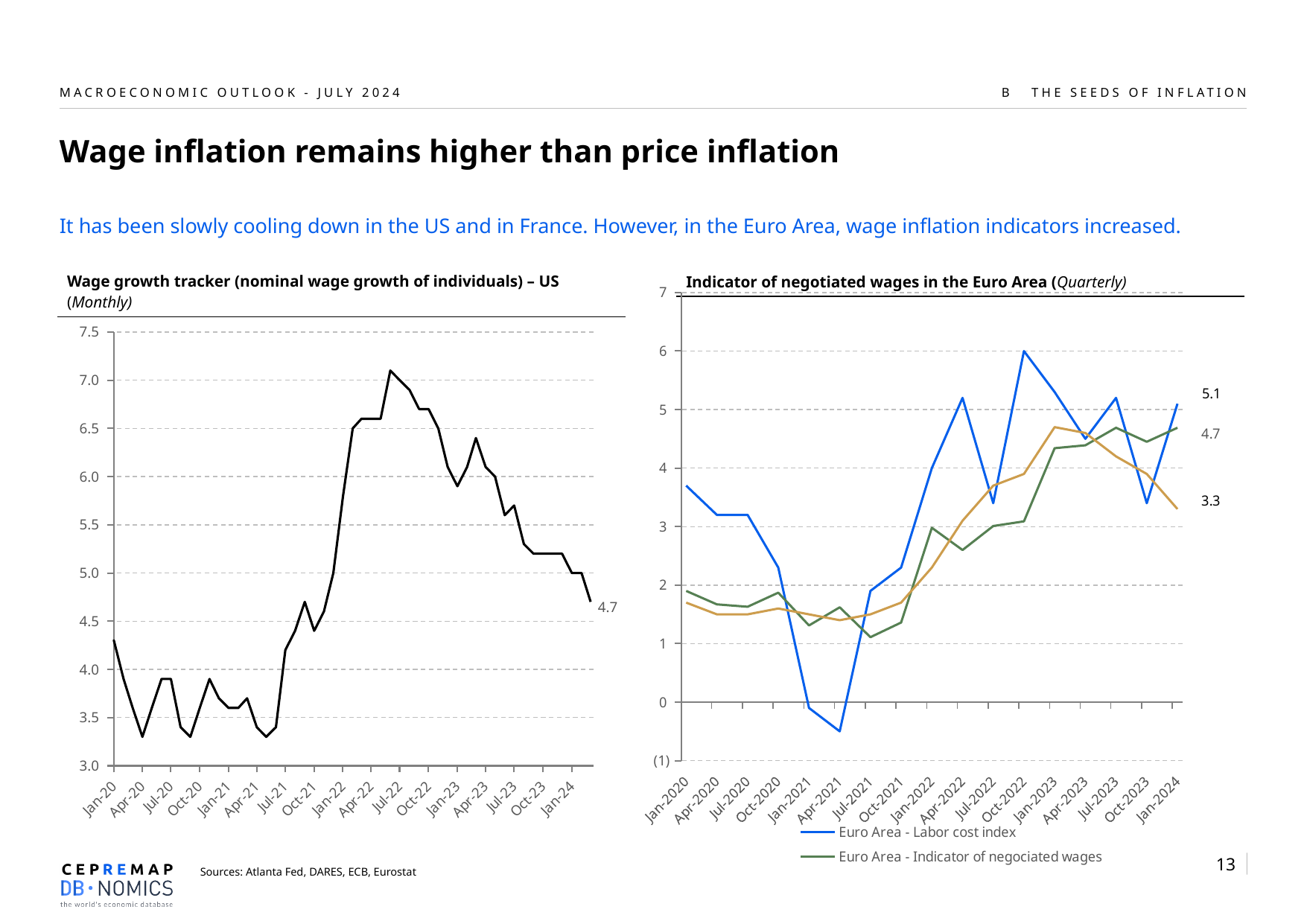
On the right chart, what is the difference between the final labelled values of the Labor cost index (5.1) and the Indicator of negotiated wages (4.7)? 0.4 On the left chart, at which date does the line reach its highest point? Jun-22 On the right chart, at the last point (Jan-2024), which series is higher: the Labor cost index or the Indicator of negotiated wages? Euro Area - Labor cost index On the left chart (Wage growth tracker – US), what is the value printed at the end of the line for the latest month? 4.7 What kind of chart is the left chart, 'Wage growth tracker (nominal wage growth of individuals) – US'? line chart On the right chart, at which date does the 'Euro Area - Labor cost index' line reach its highest point? Oct-2022 On the left chart, is the value for Jan-20 greater or less than 4.0? greater On the right chart, what is the value printed at the end of the 'Euro Area - Indicator of negotiated wages' line? 4.7 On the right chart, is the value of the Labor cost index at Apr-2021 greater or less than 0? less On the right chart (Indicator of negotiated wages in the Euro Area), how many series does the legend list? 2 On the left chart, does the line rise or fall between Jul-22 and Jan-24? fall On the right chart, what is the value printed at the end of the 'Euro Area - Labor cost index' line? 5.1